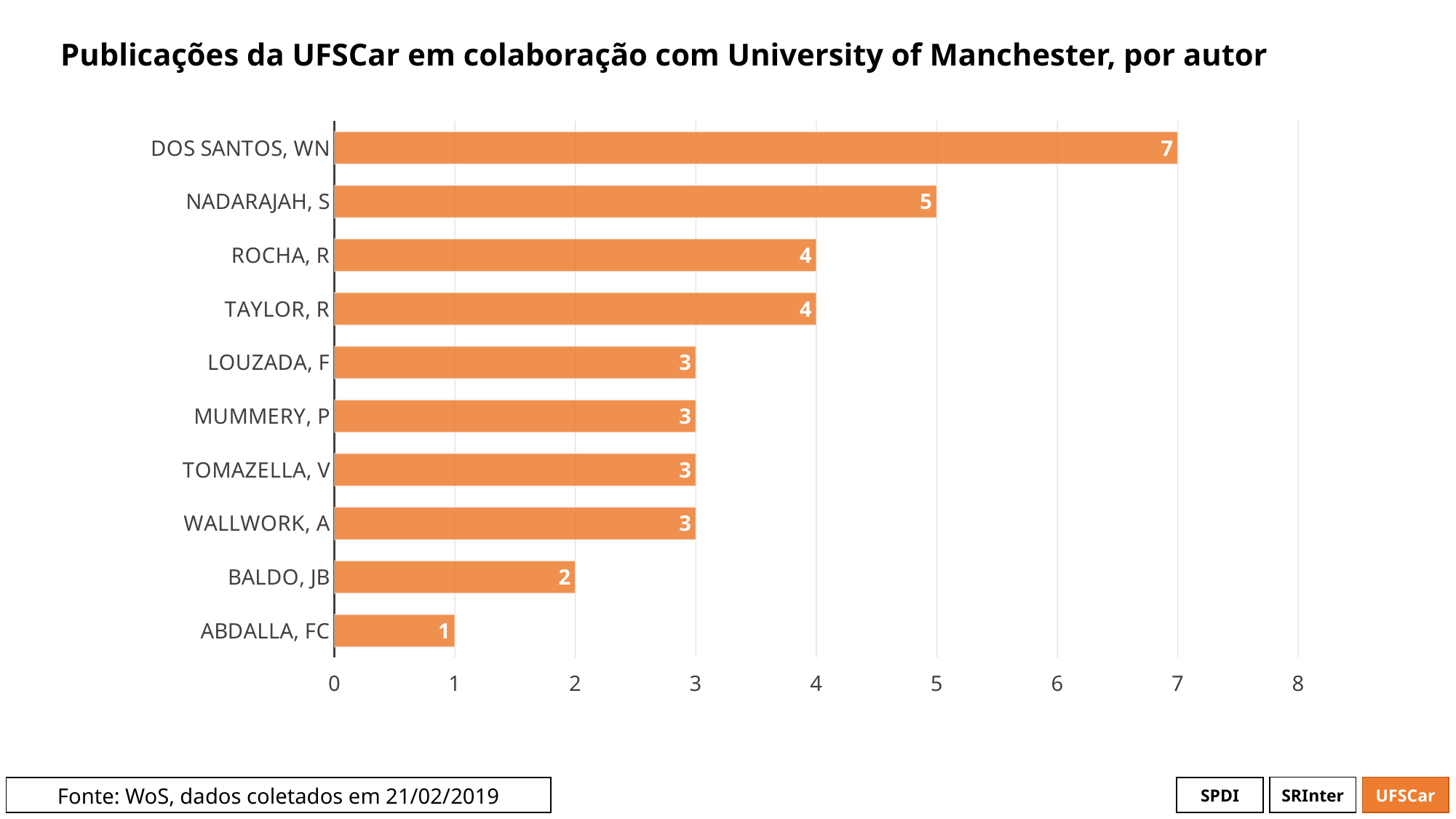
What kind of chart is shown on the slide? Bar chart What is the value shown for BALDO, JB? 2 Which author has the highest number of publications? DOS SANTOS, WN How many publications does DOS SANTOS, WN have? 7 Which author has the lowest number of publications? ABDALLA, FC What is the title of the chart? Publicações da UFSCar em colaboração com University of Manchester, por autor How many authors are shown in the chart? 10 What is the difference between the values for ROCHA, R and ABDALLA, FC? 3 Is the value for NADARAJAH, S greater or less than 4? greater What is the value shown for NADARAJAH, S? 5 Which is larger, the value for TAYLOR, R or the value for LOUZADA, F? TAYLOR, R What is the difference between the values for DOS SANTOS, WN and NADARAJAH, S? 2